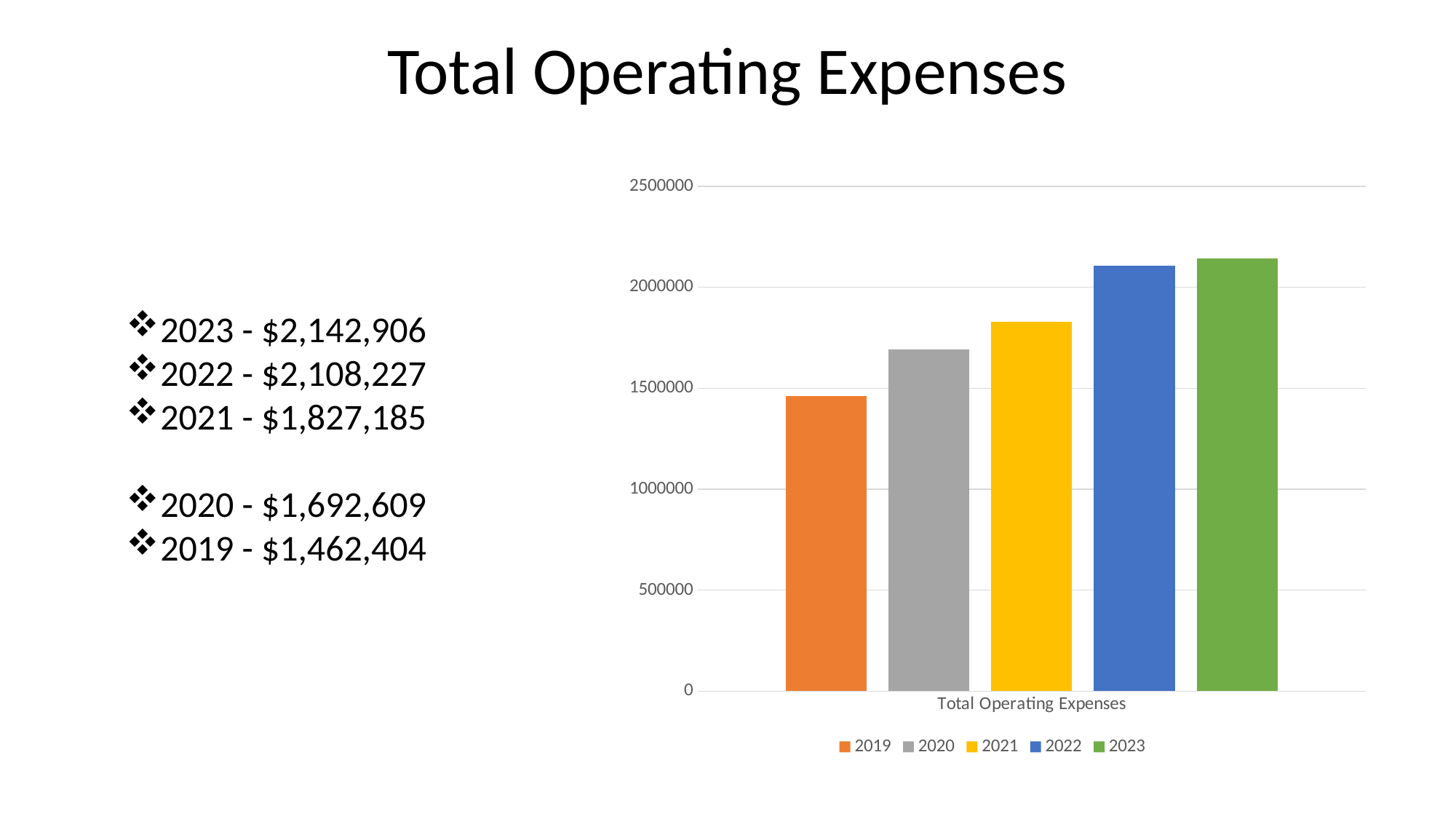
What is the value for 2021? $1,827,185 What type of chart is shown on the slide? bar chart What is the difference between the 2023 and 2022 values? $34,679 Which year has the highest total operating expenses? 2023 What is the value for 2023? $2,142,906 What is the value for 2019? $1,462,404 Do the values rise or fall from 2019 to 2023? rise How many series does the legend list? 5 Which is larger, the value for 2022 or the value for 2021? 2022 Which year has the lowest total operating expenses? 2019 Is the value for 2019 greater or less than 1500000? less What is the difference between the 2020 and 2019 values? $230,205